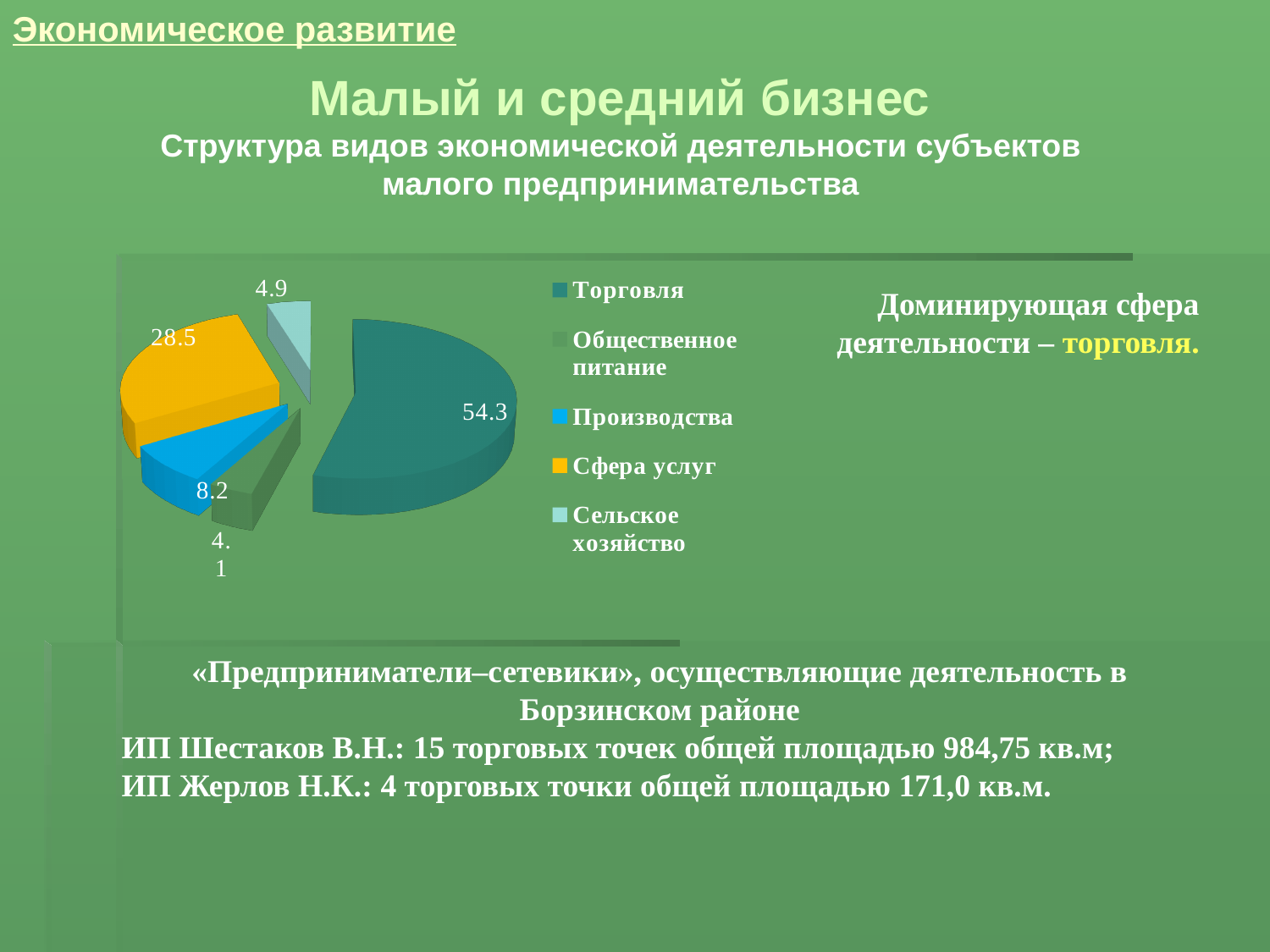
What value is shown for Сельское хозяйство in the pie chart? 4.9 How many entries does the chart legend list? 5 What value is shown for Производства in the pie chart? 8.2 Which category has the smallest slice in the pie chart? Общественное питание What value is shown for Сфера услуг in the pie chart? 28.5 What is the difference between the values for Торговля and Сфера услуг? 25.8 Which category has the largest slice in the pie chart? Торговля How many categories are shown in the pie chart? 5 According to the text next to the chart, which sphere of activity is dominant? торговля What kind of chart is shown on the slide? Pie chart What value is shown for Торговля in the pie chart? 54.3 Which is larger, the value for Производства or the value for Сельское хозяйство? Производства